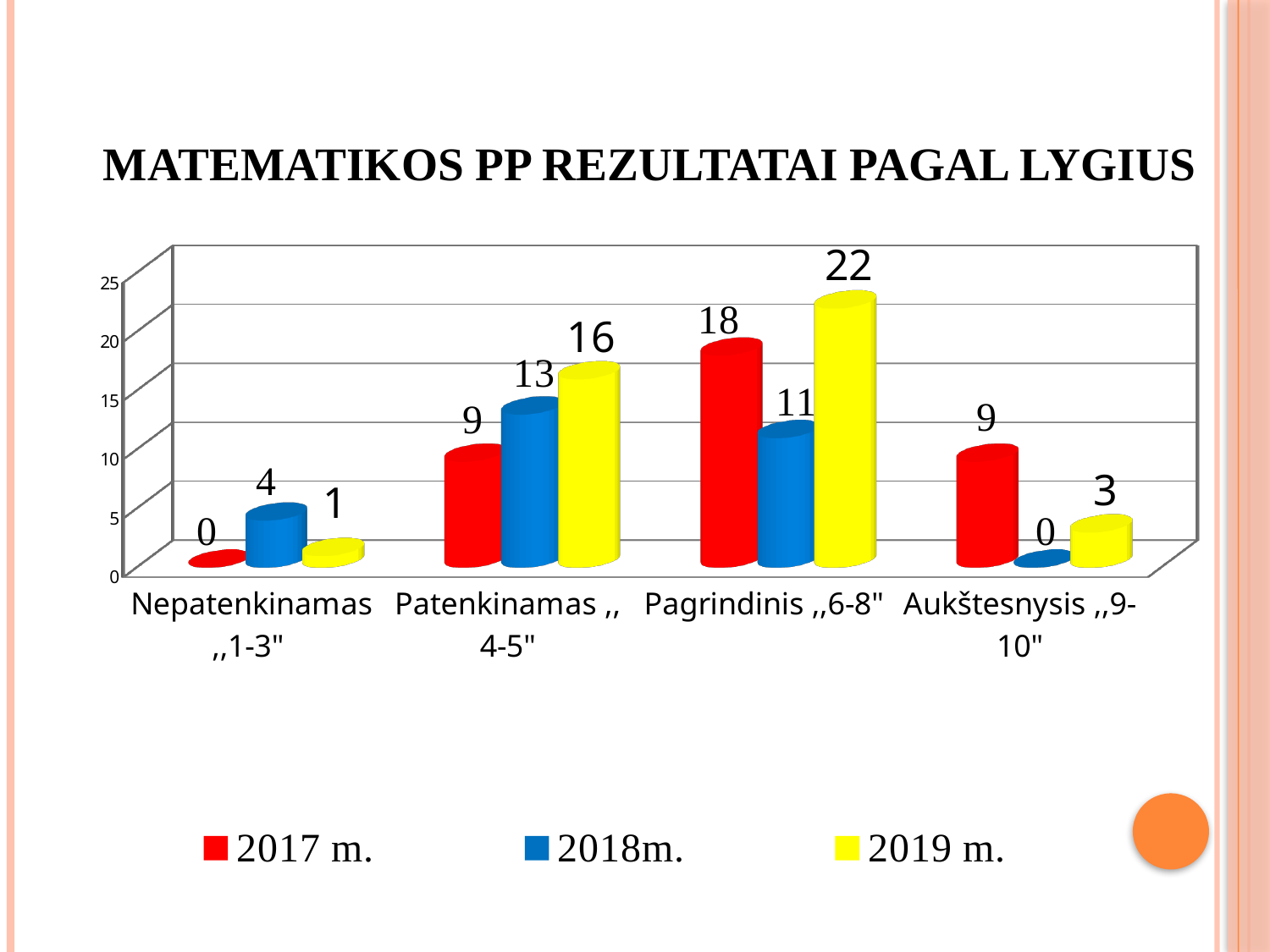
What is the value for 2017 m. in the Patenkinamas ,,4-5" category? 9 In the Patenkinamas ,,4-5" category, which series has the larger value, 2017 m. or 2018m.? 2018m. How many series does the legend list? 3 Is the value for 2017 m. in the Pagrindinis ,,6-8" category greater or less than 15? greater Which category has the highest value for the 2017 m. series? Pagrindinis ,,6-8" What kind of chart is shown on the slide? bar chart Which category has the lowest value for the 2019 m. series? Nepatenkinamas ,,1-3" What is the value for 2018m. in the Aukštesnysis ,,9-10" category? 0 What is the difference between the 2019 m. and 2018m. values in the Pagrindinis ,,6-8" category? 11 How many categories are shown on the x axis? 4 What is the value for 2019 m. in the Pagrindinis ,,6-8" category? 22 What is the title of the chart? MATEMATIKOS PP REZULTATAI PAGAL LYGIUS